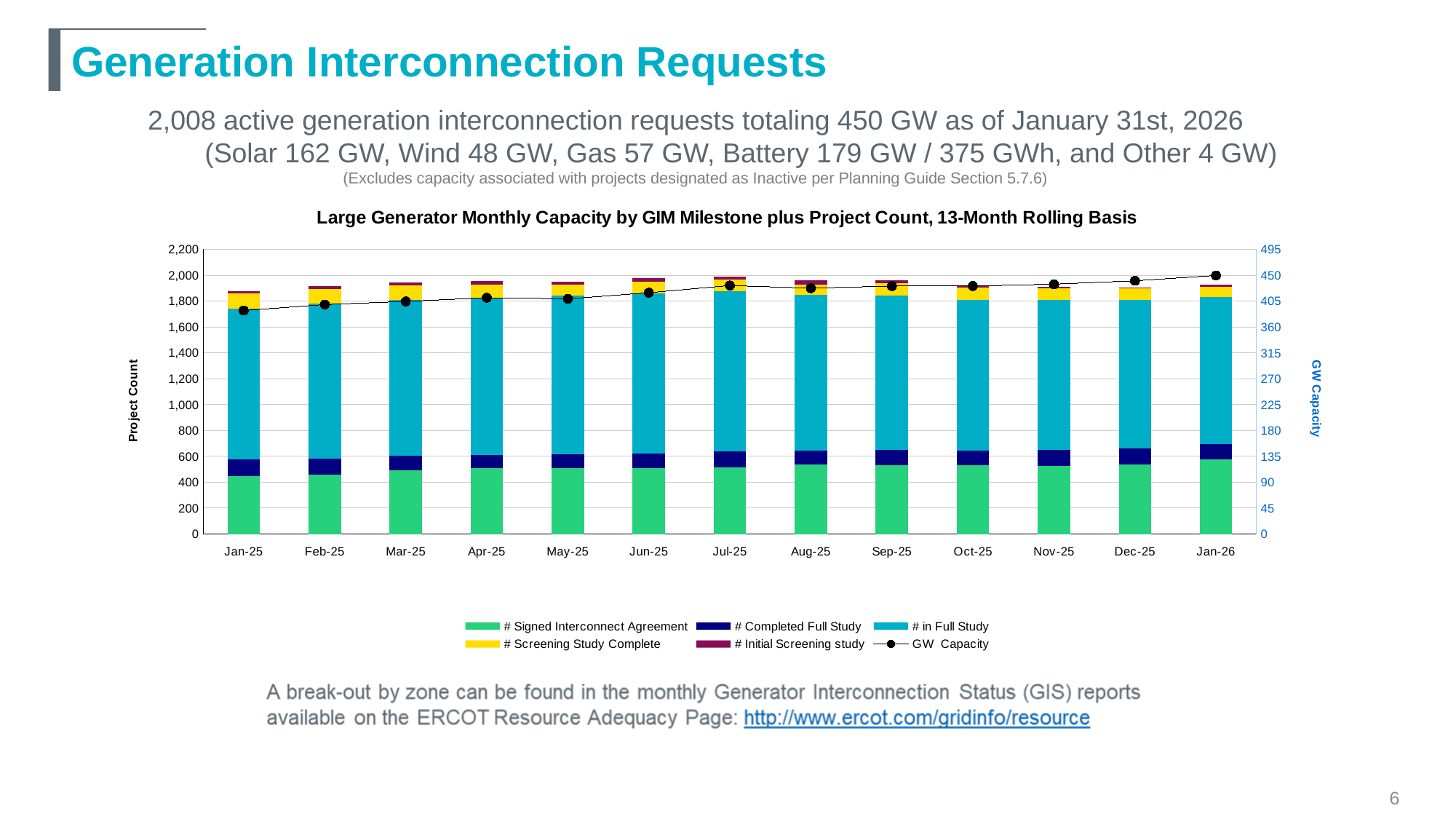
How many series does the chart legend list? 6 How many months are shown on the x axis of the chart? 13 What is the label of the right-hand vertical axis? GW Capacity Is the GW Capacity value for Jan-26 greater or less than 405? greater In which month is GW Capacity lowest? Jan-25 Is the GW Capacity value for Jan-25 greater or less than 405? less Is the total project count bar for Jan-25 greater or less than 1,800? greater In which month is GW Capacity highest? Jan-26 What is the title of the chart? Large Generator Monthly Capacity by GIM Milestone plus Project Count, 13-Month Rolling Basis Which month has the larger # Signed Interconnect Agreement segment, Jan-25 or Jan-26? Jan-26 Does the GW Capacity line rise or fall from Jan-25 to Jan-26? Rises What kind of chart is shown on the slide? Stacked bar chart with a line